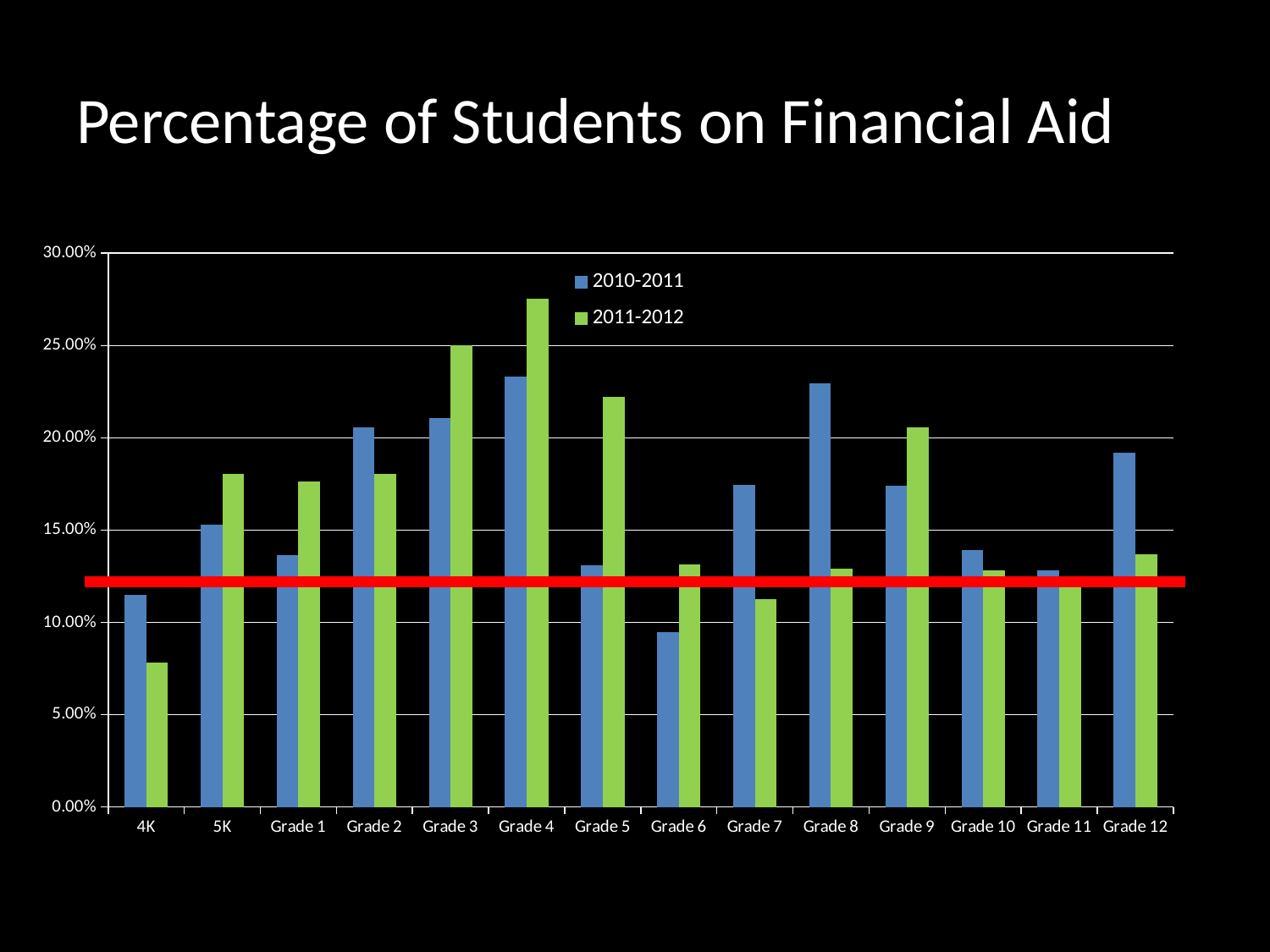
Which category has the highest value for the 2011-2012 series? Grade 4 What is the title of the chart on the slide? Percentage of Students on Financial Aid For Grade 8, which series has the larger value, 2010-2011 or 2011-2012? 2010-2011 How many grade-level categories are shown on the x axis? 14 Is the 2011-2012 value for Grade 3 greater or less than 20.00%? greater Which category has the lowest value for the 2010-2011 series? Grade 6 Which category has the lowest value for the 2011-2012 series? 4K Is the 2010-2011 value for Grade 6 greater or less than 10.00%? less What kind of chart is shown on the slide? bar chart How many series does the legend list? 2 For Grade 5, which series has the larger value, 2010-2011 or 2011-2012? 2011-2012 Is the 2011-2012 value for 4K greater or less than 10.00%? less